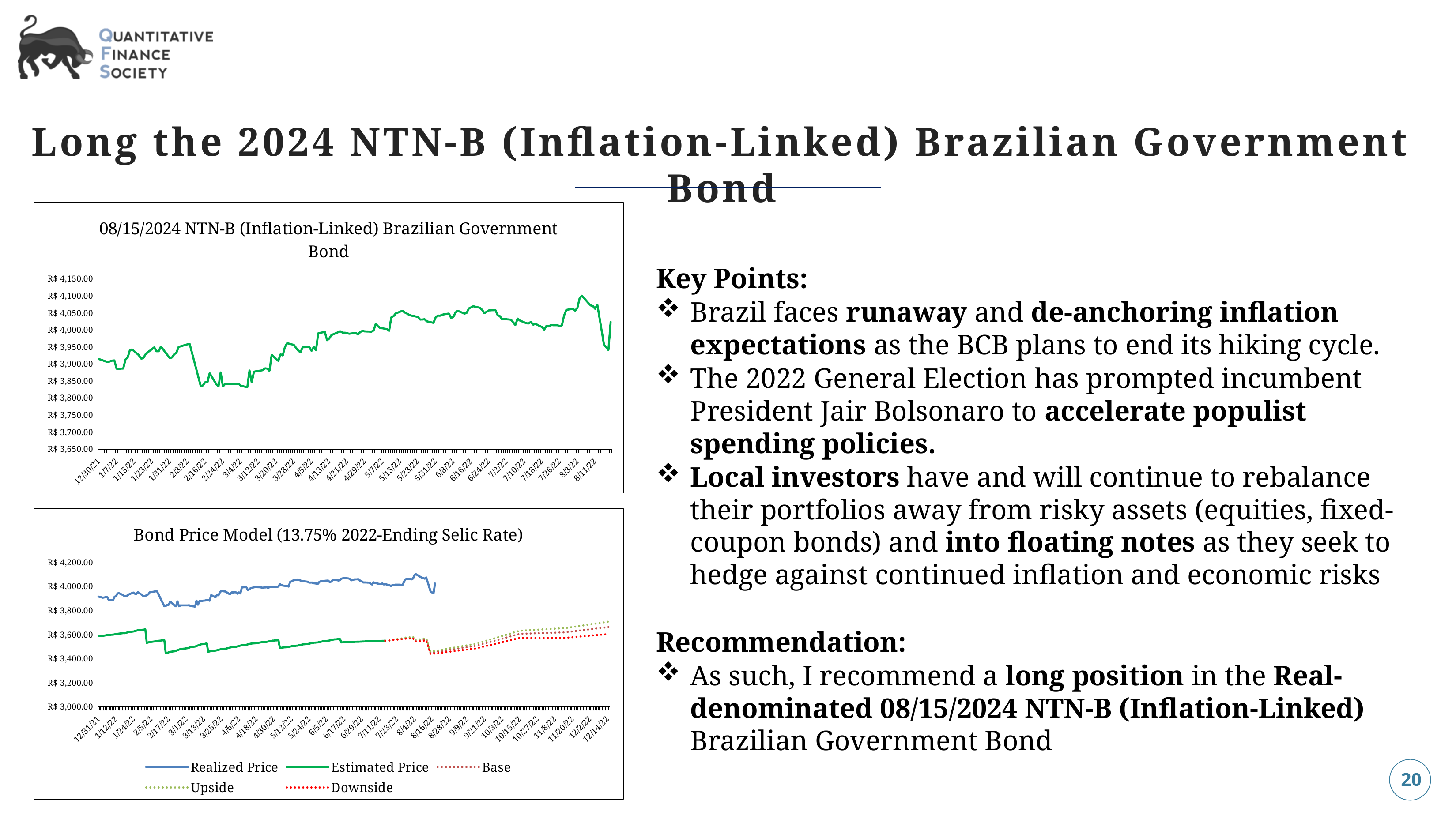
In the bottom chart 'Bond Price Model', which series is drawn in blue? Realized Price In the top chart, does the bond price overall rise or fall from 12/30/21 to the end of the series? rise In the top chart, is the bond price around 7/2/22 greater or less than R$ 4,000.00? greater In the top chart, is the bond price around 2/24/22 greater or less than R$ 3,900.00? less What type of chart is the top chart titled '08/15/2024 NTN-B (Inflation-Linked) Brazilian Government Bond'? Line chart In the top chart, is the peak bond price around 8/3/22 greater or less than R$ 4,050.00? greater How many series does the legend of the bottom chart 'Bond Price Model (13.75% 2022-Ending Selic Rate)' list? 5 In the bottom chart 'Bond Price Model', which scenario line is higher at 12/14/22: Upside or Downside? Upside In the bottom chart 'Bond Price Model', which is higher at 12/31/21: the Realized Price or the Estimated Price? Realized Price